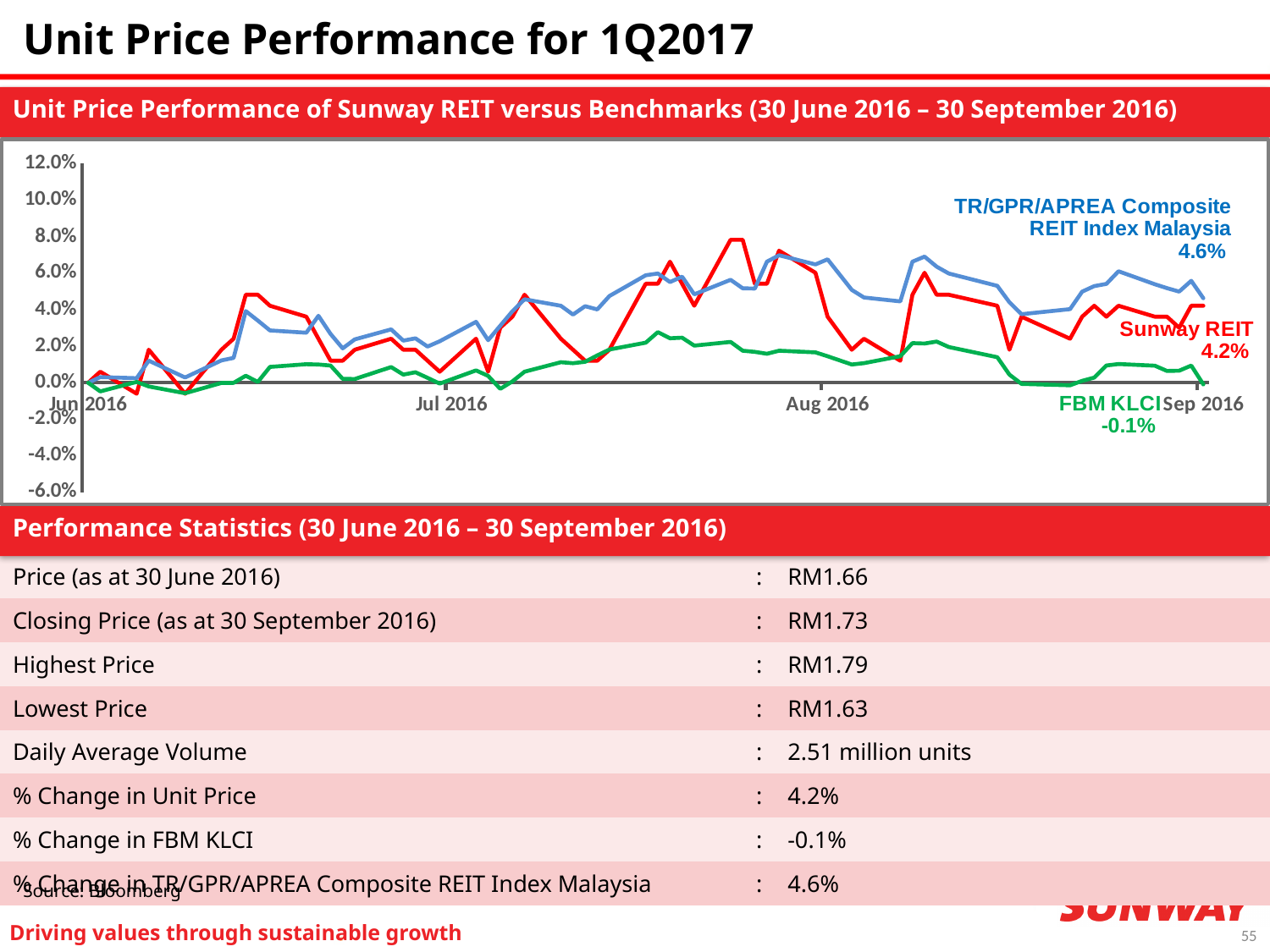
Which series has the lowest labelled end value on the chart? FBM KLCI How many series are plotted on the chart? 3 What is the difference between the labelled end values of the TR/GPR/APREA Composite REIT Index Malaysia and Sunway REIT? 0.4 percentage points Is the peak value of the Sunway REIT line greater or less than 6.0%? greater What kind of chart is shown on the slide? Line chart What is the end value shown for FBM KLCI on the chart? -0.1% What is the end value shown for Sunway REIT on the chart? 4.2% What colour is the Sunway REIT line on the chart? Red What is the end value shown for the TR/GPR/APREA Composite REIT Index Malaysia on the chart? 4.6% Which has the larger labelled end value, Sunway REIT or FBM KLCI? Sunway REIT Which series has the highest labelled end value on the chart? TR/GPR/APREA Composite REIT Index Malaysia Does the Sunway REIT line overall rise or fall from June 2016 to September 2016? Rise